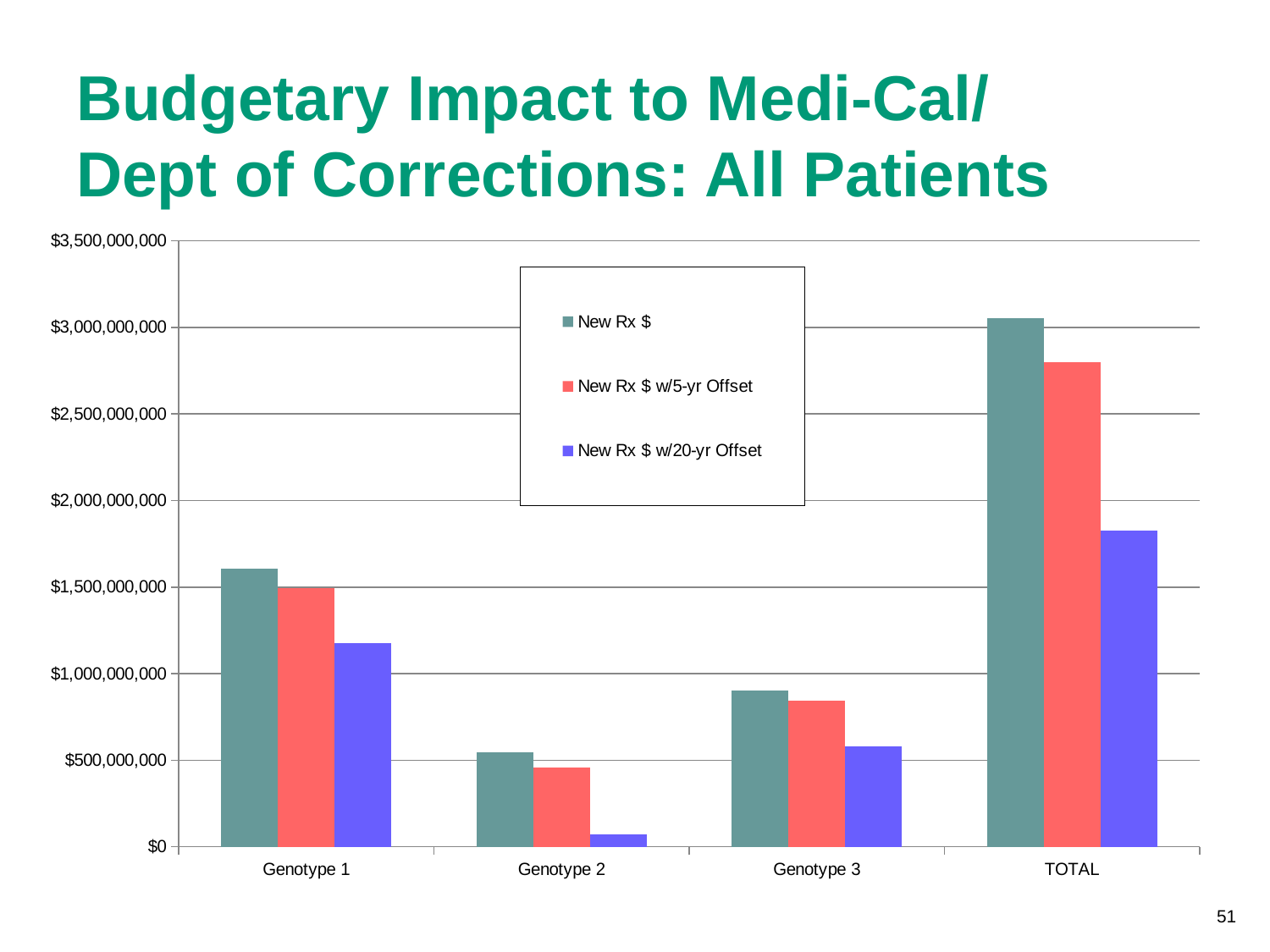
Among Genotype 1, Genotype 2 and Genotype 3, which has the highest New Rx $ value? Genotype 1 Is the New Rx $ value for Genotype 3 greater or less than $1,000,000,000? less Is the New Rx $ w/5-yr Offset value for TOTAL greater or less than $2,500,000,000? greater Is the New Rx $ w/20-yr Offset value for TOTAL greater or less than $2,000,000,000? less How many series does the legend list? 3 How many categories are shown on the x axis? 4 Which category has the tallest New Rx $ bar? TOTAL What kind of chart is shown on the slide? bar chart Which is larger, the New Rx $ w/5-yr Offset value for Genotype 3 or for Genotype 2? Genotype 3 Which colour represents the New Rx $ w/20-yr Offset series in the legend? blue Among Genotype 1, Genotype 2 and Genotype 3, which has the lowest New Rx $ w/20-yr Offset value? Genotype 2